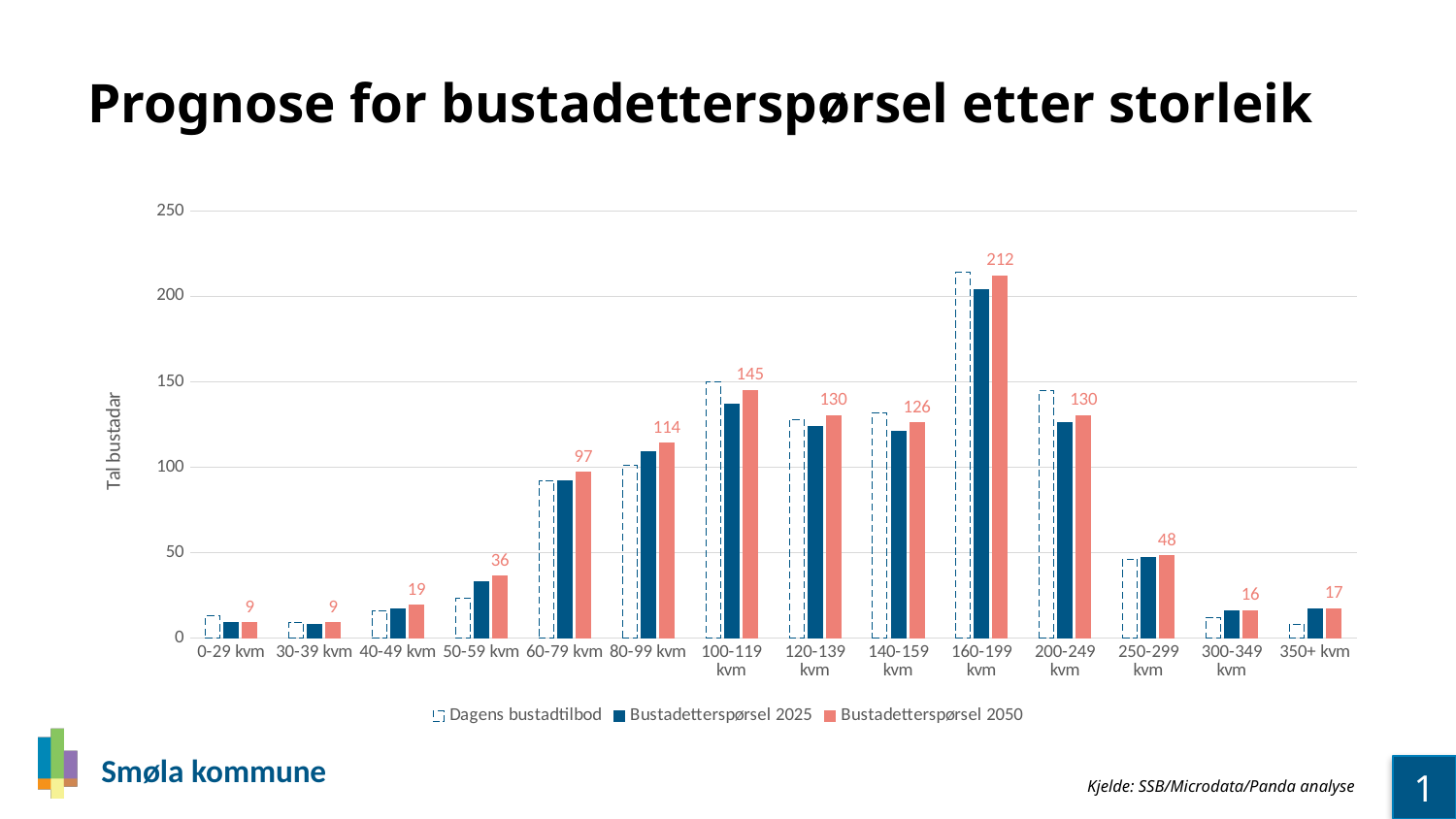
Which category has the highest value for Bustadetterspørsel 2050? 160-199 kvm Which is larger for Bustadetterspørsel 2050: 120-139 kvm or 140-159 kvm? 120-139 kvm What is the title of the chart? Prognose for bustadetterspørsel etter storleik How many series does the legend list? 3 What is the value for Bustadetterspørsel 2050 in the 160-199 kvm category? 212 What kind of chart is shown on the slide? Bar chart What is the difference between the Bustadetterspørsel 2050 values for 160-199 kvm and 100-119 kvm? 67 What is the value for Bustadetterspørsel 2050 in the 250-299 kvm category? 48 Is the value for Bustadetterspørsel 2025 in the 160-199 kvm category greater or less than 150? greater Is the value for Dagens bustadtilbod in the 50-59 kvm category greater or less than 50? less How many size categories are shown on the x axis? 14 What is the value for Bustadetterspørsel 2050 in the 60-79 kvm category? 97